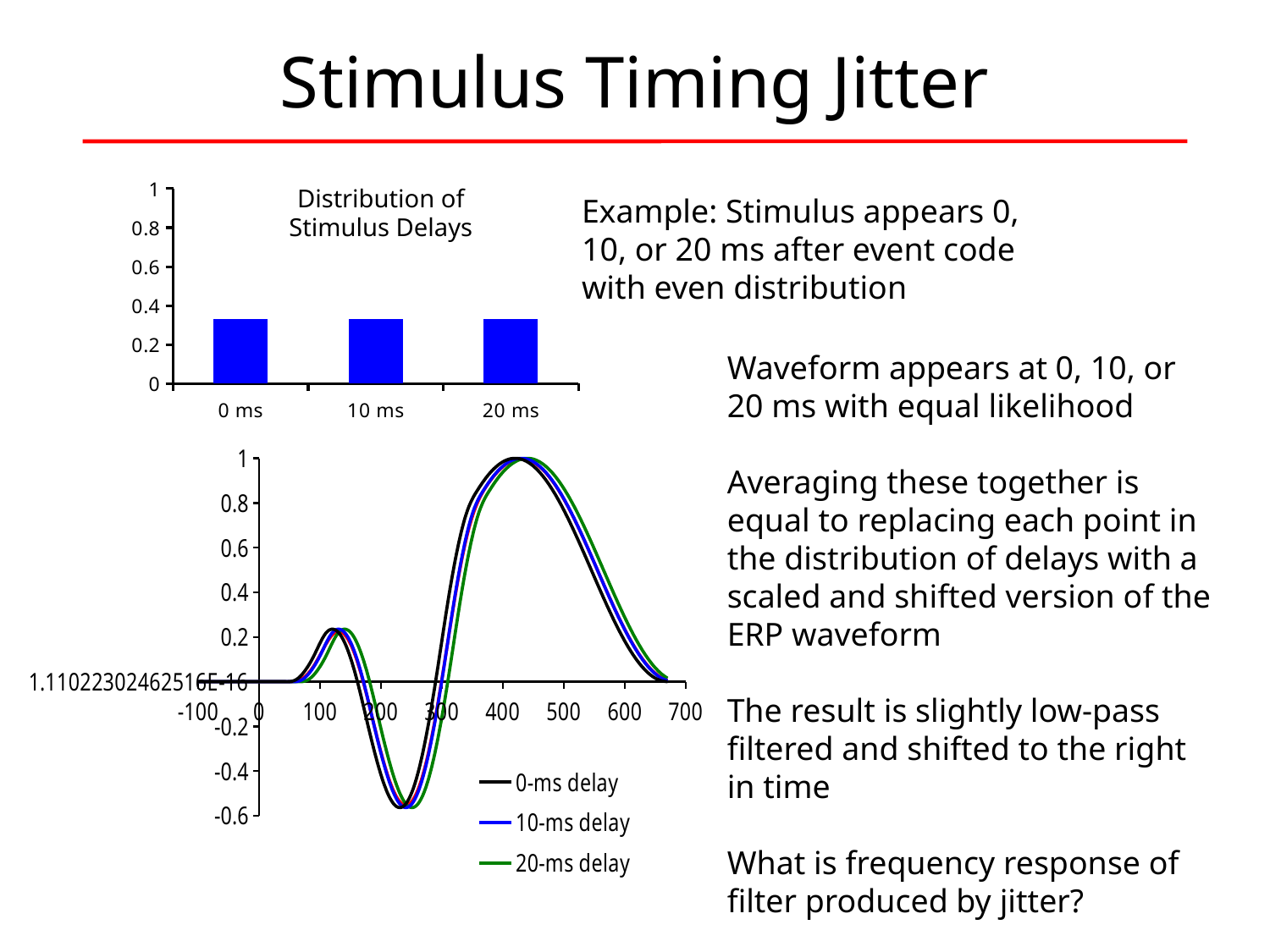
In the bottom chart, is the peak value of the 0-ms delay series near 400 ms greater or less than 0.8? greater What kind of chart is the top chart, Distribution of Stimulus Delays? bar chart How many categories are shown in the top chart, Distribution of Stimulus Delays? 3 In the bottom chart, does the 0-ms delay series rise or fall between 300 ms and 400 ms on the x axis? rise What kind of chart is the bottom chart on the slide? line chart What is the title of the top chart? Distribution of Stimulus Delays In the bottom chart, is the lowest value of the 0-ms delay series near 200 ms greater or less than -0.4? less What colour are the bars in the top chart, Distribution of Stimulus Delays? blue In the bottom chart, which series is drawn in green? 20-ms delay In the top chart, Distribution of Stimulus Delays, is the value for 10 ms greater or less than 0.2? greater How many series does the legend of the bottom chart list? 3